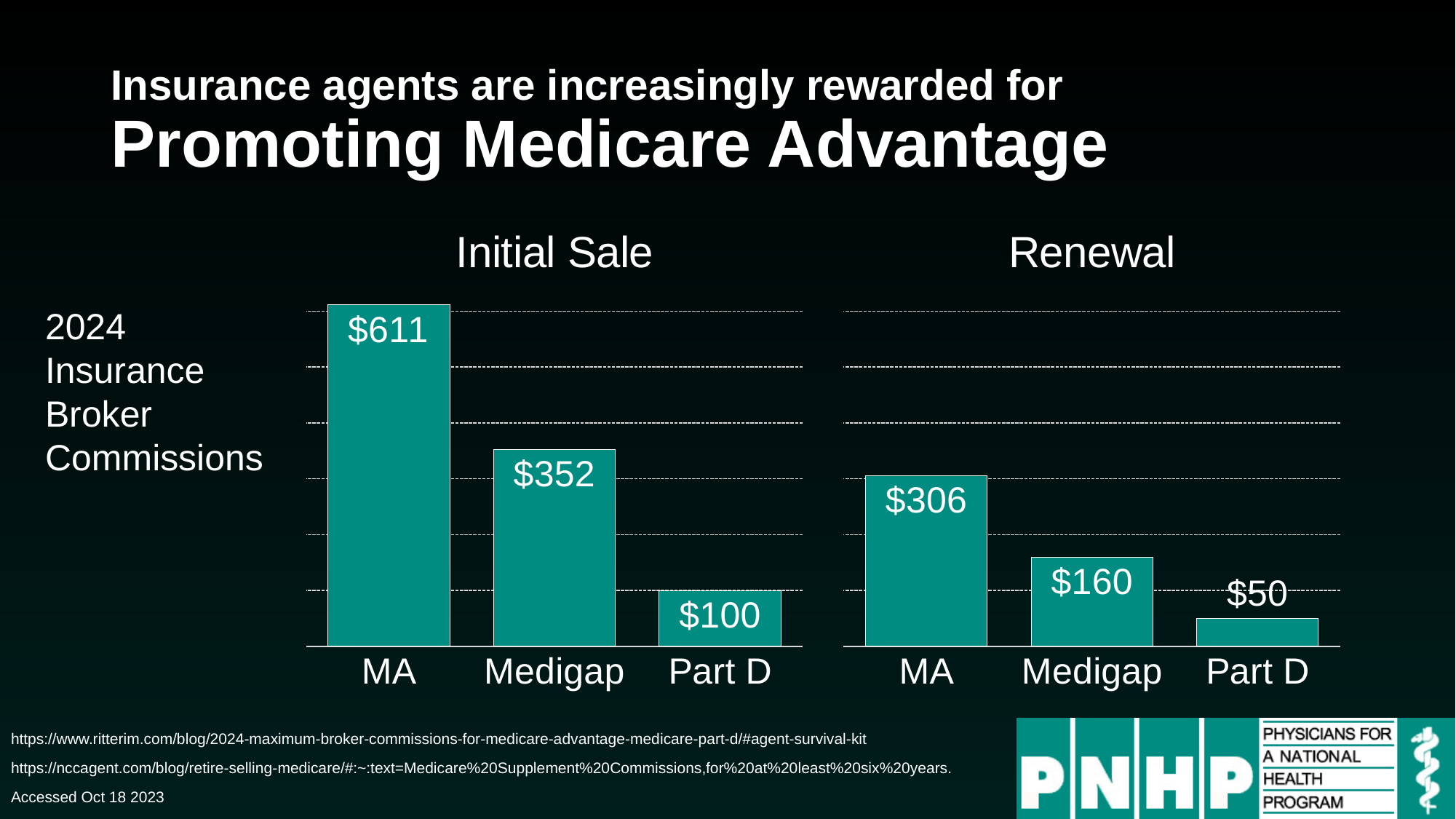
In the Renewal chart, do the values rise or fall from MA to Part D? Fall In the Renewal chart, which category has the lowest commission? Part D In the Initial Sale chart, which category has the highest commission? MA In the Initial Sale chart, what is the commission for Medigap? $352 In the Renewal chart, what is the commission for Medigap? $160 How many categories are shown in the Renewal chart? 3 In the Initial Sale chart, what is the commission for MA? $611 In the Renewal chart, what is the commission for Part D? $50 In the Initial Sale chart, what is the difference between the MA and Medigap commissions? $259 Which is larger: the MA commission in the Renewal chart or the Medigap commission in the Initial Sale chart? Medigap in the Initial Sale chart In the Renewal chart, what is the difference between the MA and Part D commissions? $256 What type of chart is the Initial Sale chart? Bar chart